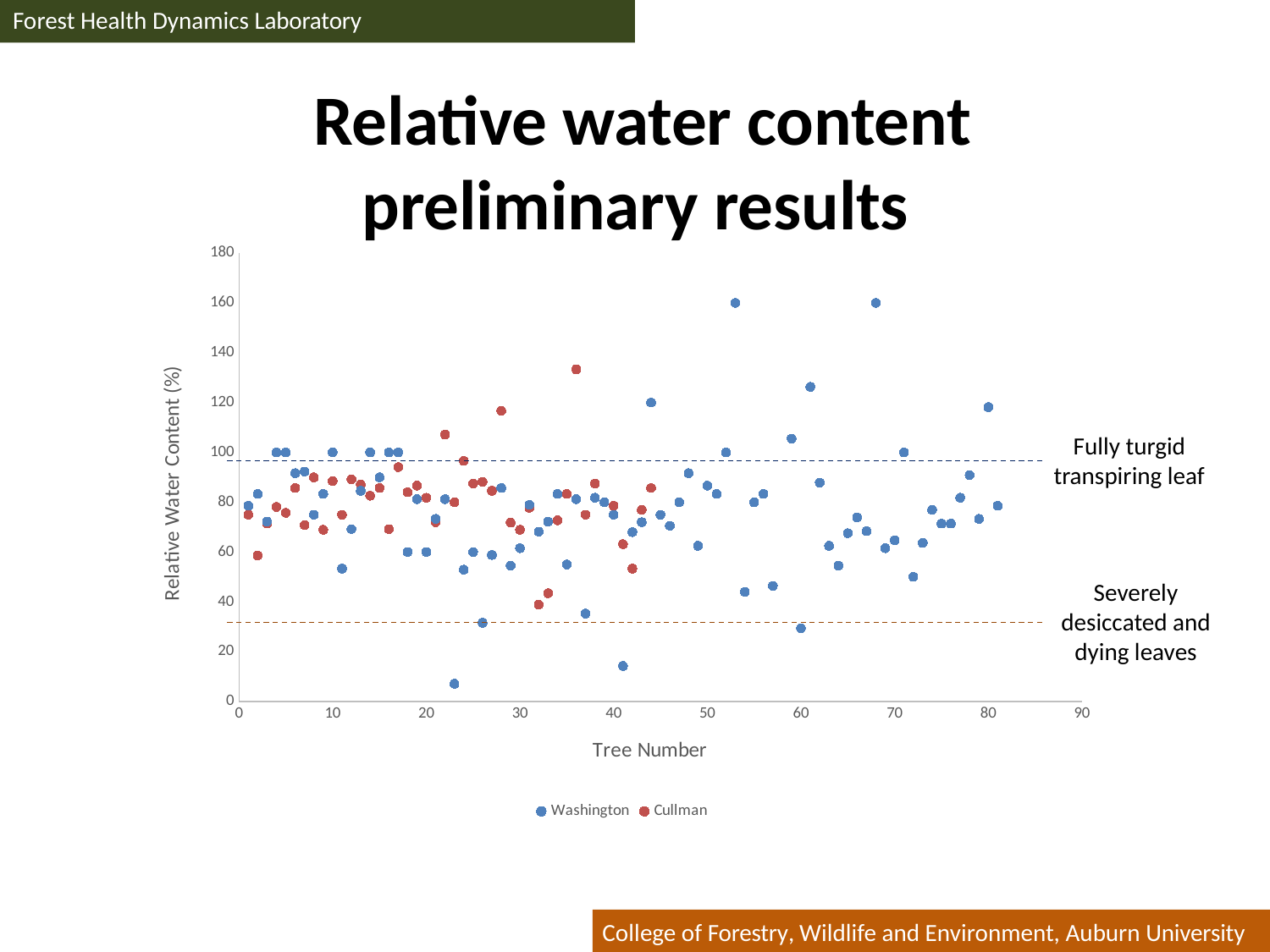
Is the highest value in the Cullman series greater or less than 120? greater How many series does the legend list? 2 Which series contains the lowest plotted point on the chart? Washington What are the two series named in the legend? Washington and Cullman Is the lowest value in the Washington series greater or less than 20? less What is the maximum value shown on the vertical axis? 180 What is the label of the vertical axis? Relative Water Content (%) What is the label of the horizontal axis? Tree Number Is the highest value in the Washington series greater or less than 140? greater What is the title of the chart? Relative water content preliminary results What kind of chart is shown on the slide? Scatter chart Which series contains the highest plotted point on the chart? Washington